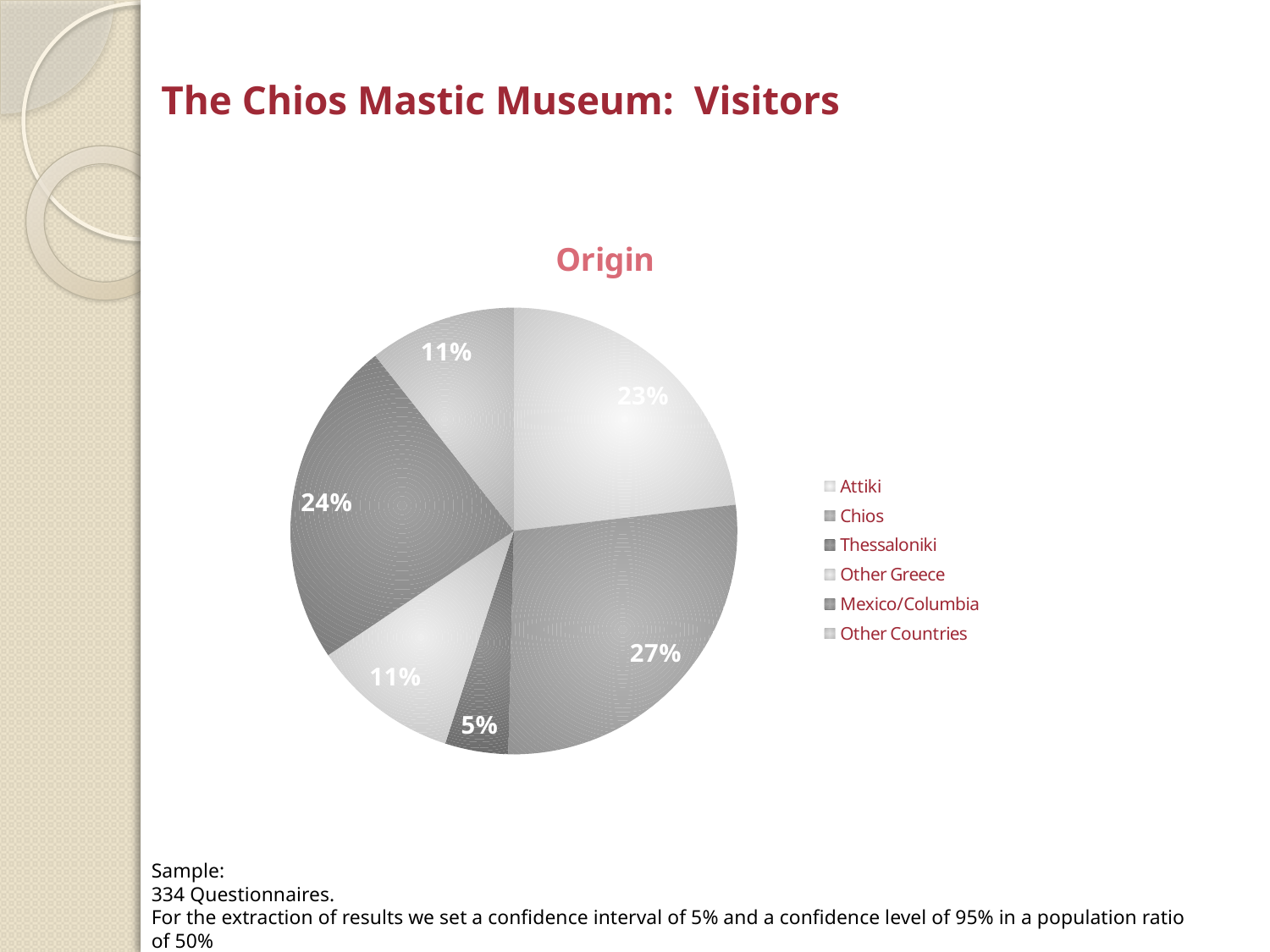
What share of visitors come from Thessaloniki according to the Origin pie chart? 5% What share of visitors come from Chios according to the Origin pie chart? 27% What share of visitors come from Mexico/Columbia according to the Origin pie chart? 24% What is the title of the chart? Origin What is the combined share of Other Greece and Other Countries in the Origin pie chart? 22% Which has a larger share in the Origin pie chart, Chios or Mexico/Columbia? Chios Which origin has the smallest share in the Origin pie chart? Thessaloniki Which origin has the largest share in the Origin pie chart? Chios What type of chart is shown on the slide? pie chart What is the difference in percentage points between the Chios share and the Attiki share in the Origin pie chart? 4 How many categories does the legend of the Origin pie chart list? 6